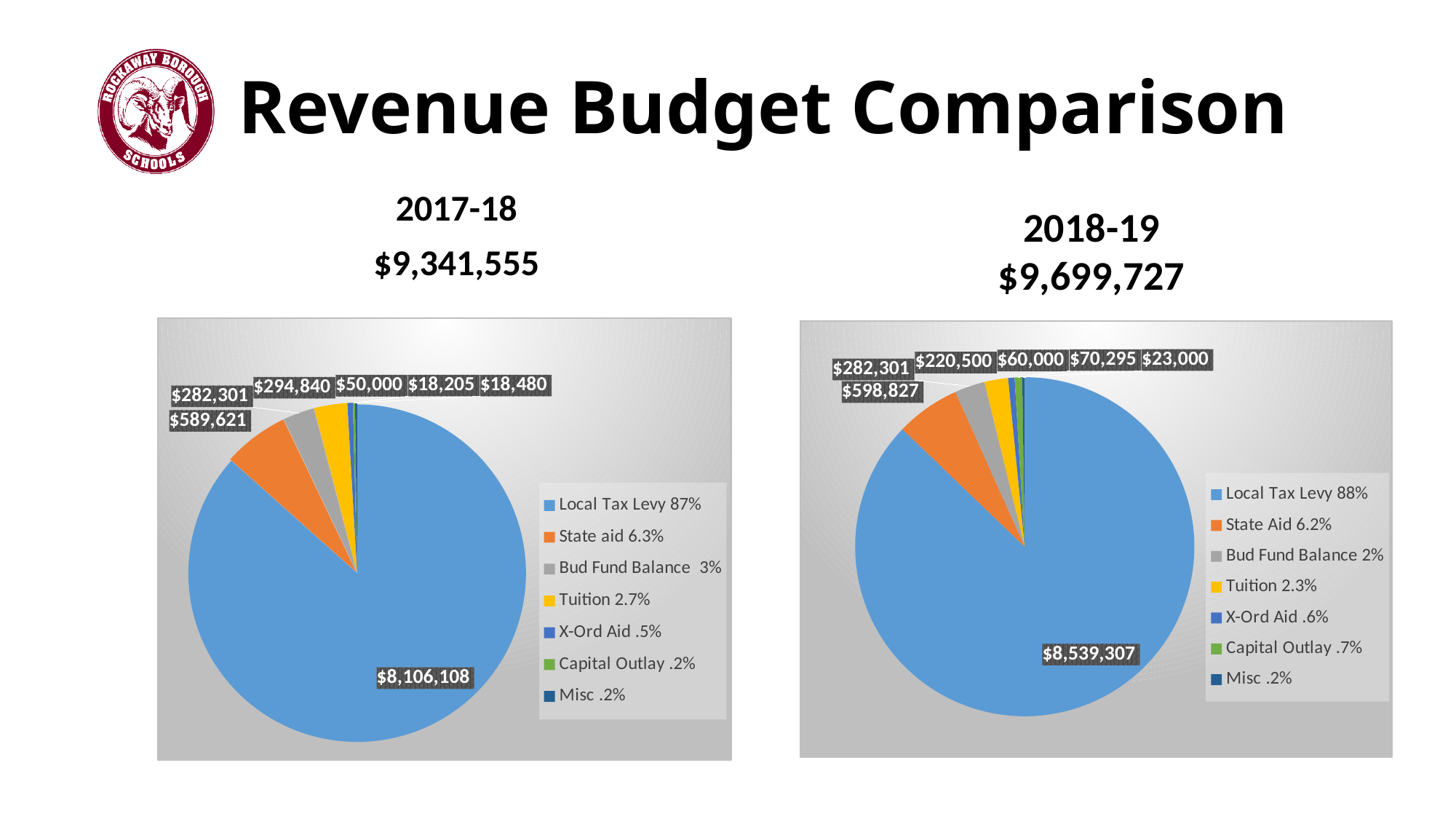
In the 2017-18 chart, what is the value of the State aid slice? $589,621 In the 2017-18 chart, what share of the pie does Local Tax Levy represent according to the legend? 87% In the 2018-19 chart, what share of the pie does Tuition represent according to the legend? 2.3% In the 2017-18 chart, what is the value of the Local Tax Levy slice? $8,106,108 What is the difference between the Local Tax Levy value in the 2018-19 chart and the Local Tax Levy value in the 2017-18 chart? $433,199 In the 2018-19 chart, what is the value of the State Aid slice? $598,827 What is the total revenue budget shown above the 2018-19 chart? $9,699,727 Which is larger: the State aid value in the 2017-18 chart or the State Aid value in the 2018-19 chart? 2018-19 How many categories does the legend of the 2018-19 chart list? 7 What kind of chart is used for the 2017-18 revenue budget? Pie chart In the 2017-18 chart, which category has the largest slice? Local Tax Levy In the 2018-19 chart, what is the value of the Local Tax Levy slice? $8,539,307